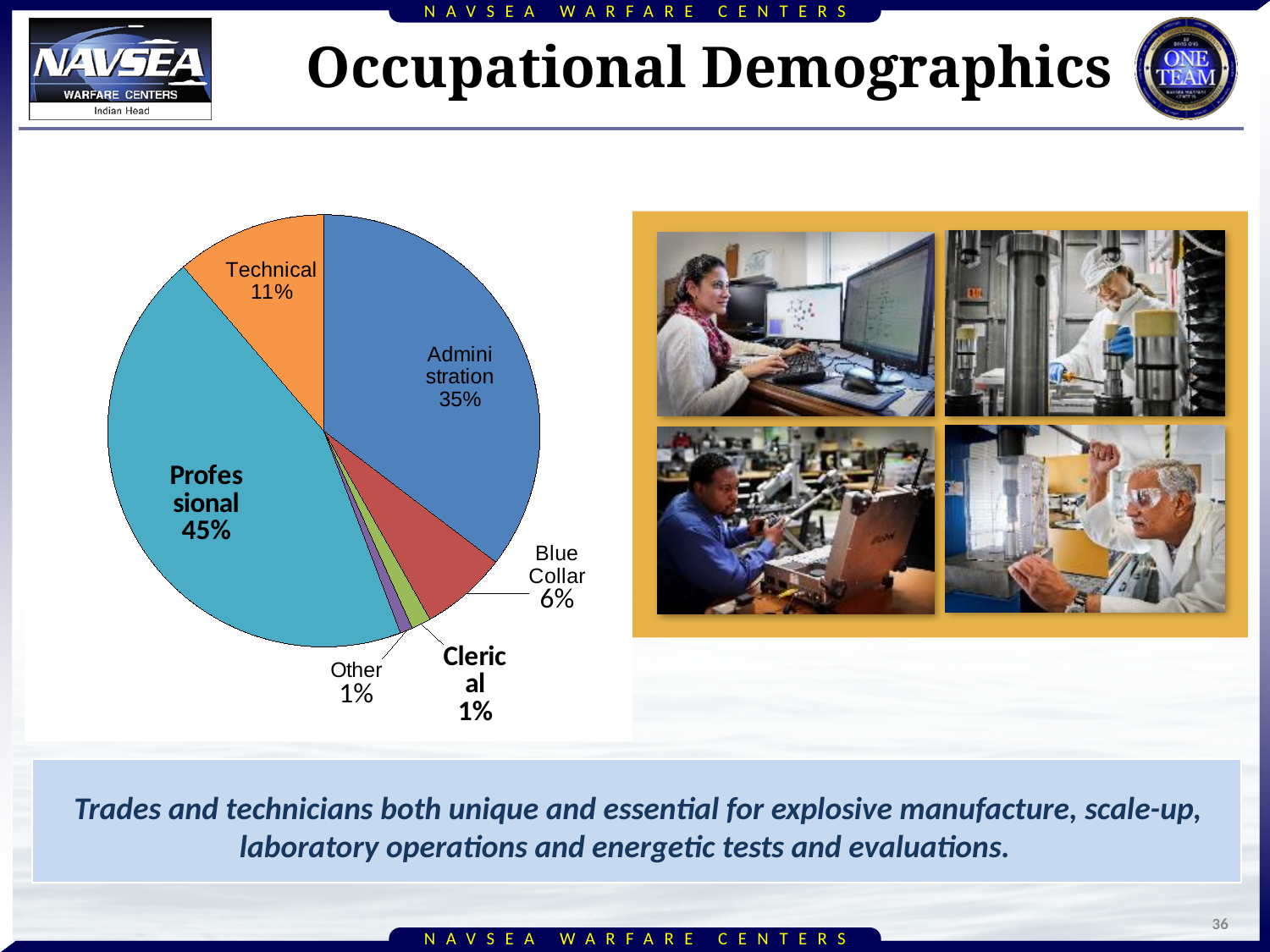
What is the combined share of Other and Clerical? 2% Which is larger, Technical or Blue Collar? Technical What share of the pie does Administration hold? 35% What colour is the Technical slice? Orange Which category has the largest slice of the pie? Professional What is the title of the slide containing the chart? Occupational Demographics How many categories are shown in the pie chart? 6 What share of the pie does Technical hold? 11% What share of the pie does Blue Collar hold? 6% What share of the pie does Professional hold? 45% What is the difference in percentage points between Professional and Administration? 10 What kind of chart is shown on the slide? Pie chart